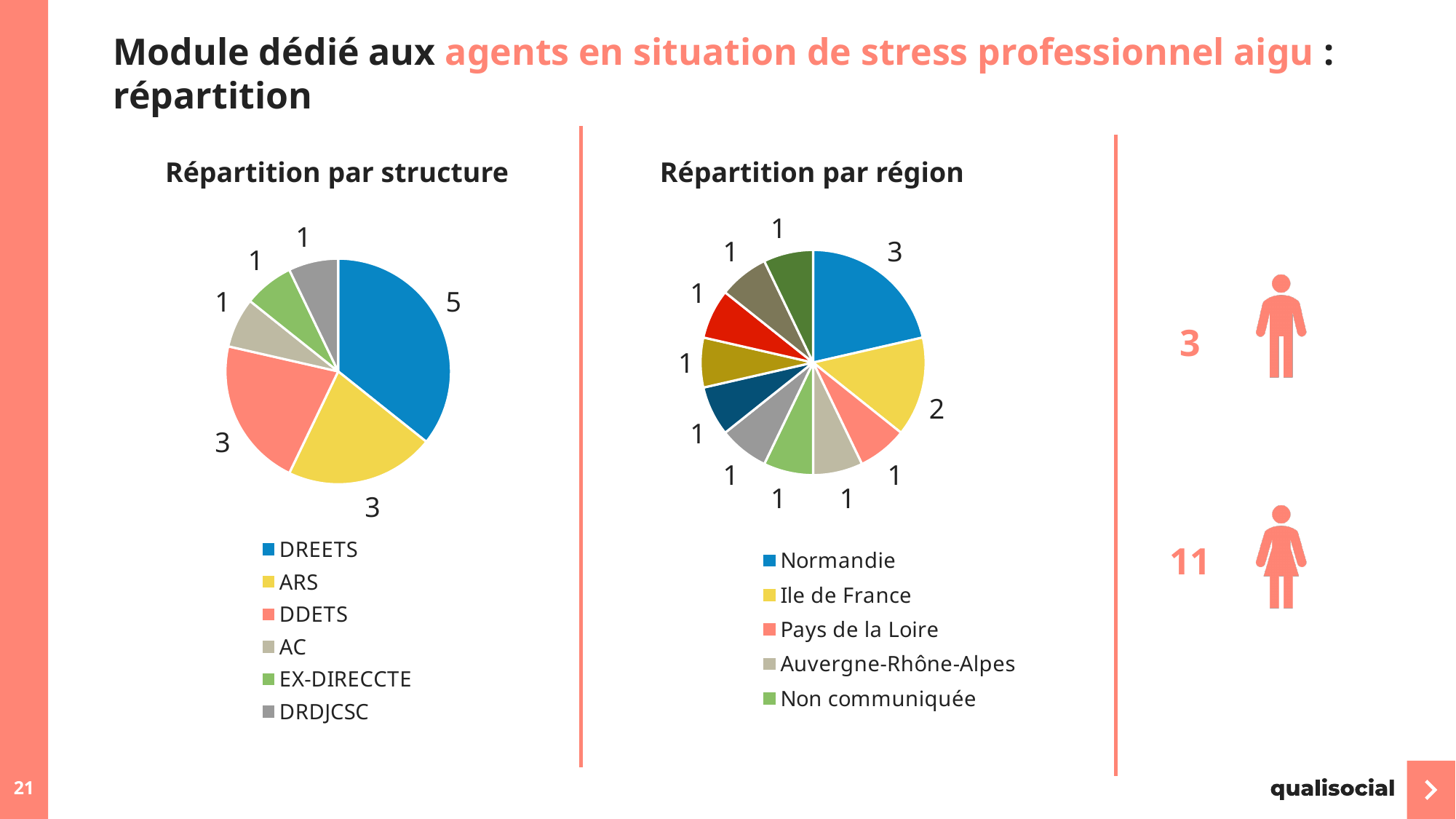
In the 'Répartition par région' chart, what colour is the Normandie slice? Blue In the 'Répartition par structure' chart, what is the value for DREETS? 5 What kind of chart is 'Répartition par structure'? Pie chart In the 'Répartition par région' chart, which region has the largest slice? Normandie In the 'Répartition par région' chart, what is the value for Ile de France? 2 In the 'Répartition par structure' chart, which structure has the largest slice? DREETS How many slices does the 'Répartition par région' pie chart have? 11 How many entries does the legend of the 'Répartition par structure' chart list? 6 In the 'Répartition par structure' chart, which is larger, the value for ARS or the value for AC? ARS In the 'Répartition par structure' chart, what is the difference between the DREETS value and the ARS value? 2 In the 'Répartition par structure' chart, what is the value for DDETS? 3 In the 'Répartition par région' chart, what is the value for Normandie? 3